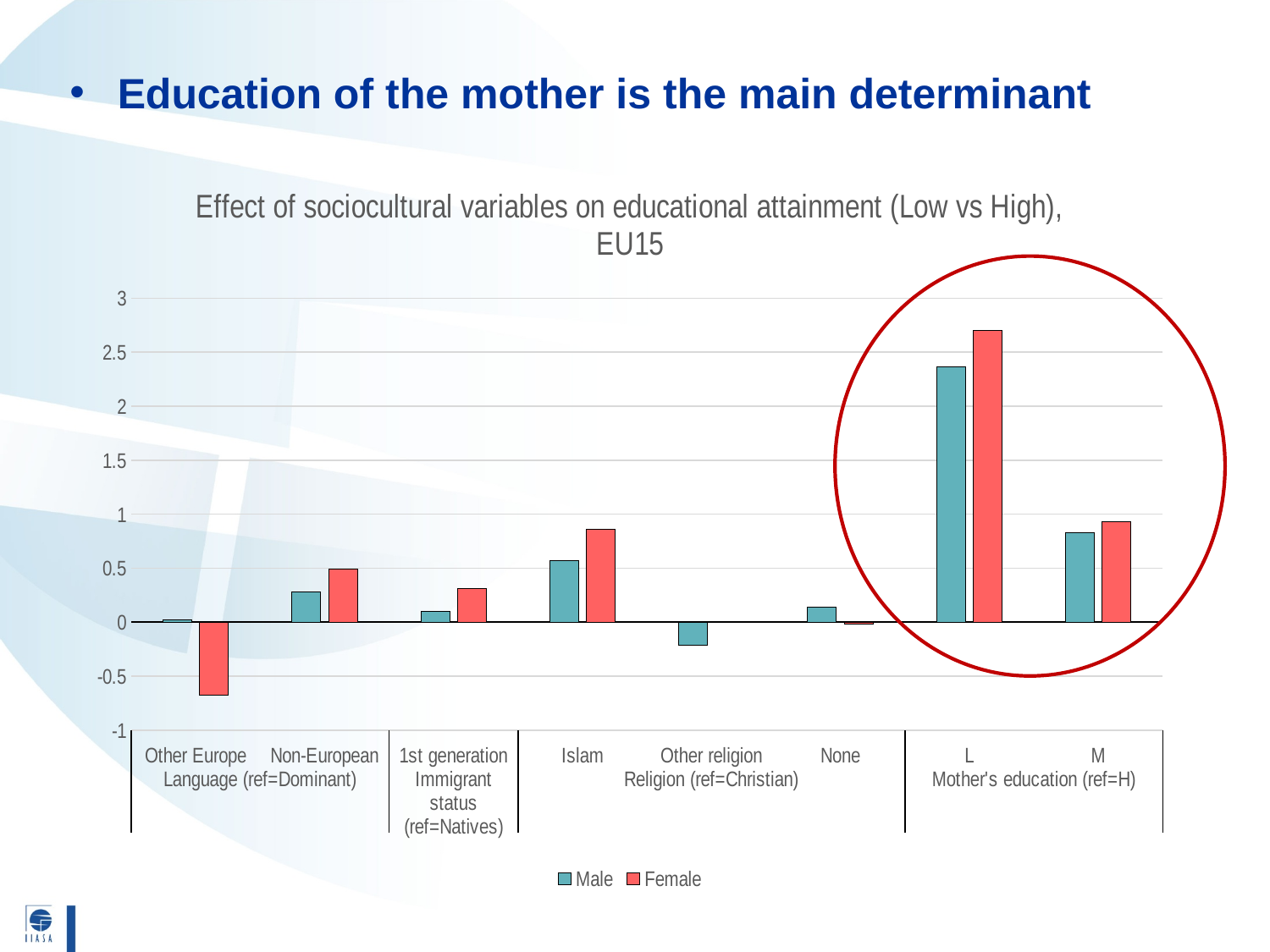
Is the Male value for L greater or less than 2.5? less Which category has the lowest Male value? Other religion For Islam, which is larger, the Male value or the Female value? Female How many categories are plotted along the x axis? 8 Which category has the highest Female value? L How many series does the legend list? 2 What kind of chart is shown on the slide? bar chart Which category has the highest Male value? L Which category has the lowest Female value? Other Europe Is the Female value for Other Europe greater or less than -0.5? less What is the title of the chart? Effect of sociocultural variables on educational attainment (Low vs High), EU15 Is the Female value for L greater or less than 2.5? greater